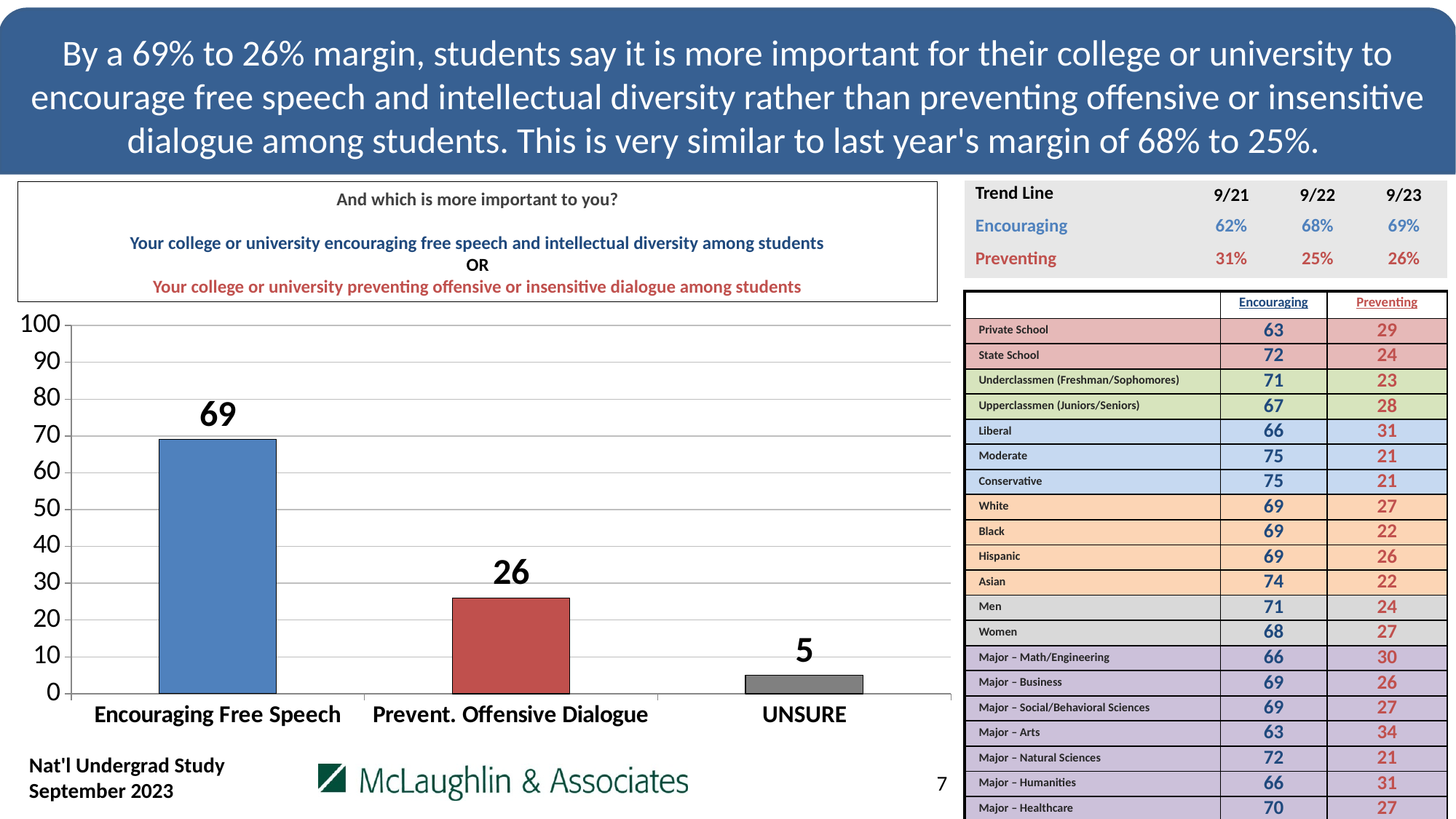
Which is larger, the value for Prevent. Offensive Dialogue or the value for UNSURE? Prevent. Offensive Dialogue What is the value for Prevent. Offensive Dialogue in the bar chart? 26 Is the value for Encouraging Free Speech greater or less than 60? greater What colour is the bar for Prevent. Offensive Dialogue? red Which category has the highest value in the bar chart? Encouraging Free Speech How many categories are shown in the bar chart? 3 What is the highest value shown on the y axis of the bar chart? 100 What kind of chart is shown on the slide? bar chart Which category has the lowest value in the bar chart? UNSURE What is the value for UNSURE in the bar chart? 5 What is the difference between the values for Encouraging Free Speech and Prevent. Offensive Dialogue? 43 What is the value for Encouraging Free Speech in the bar chart? 69